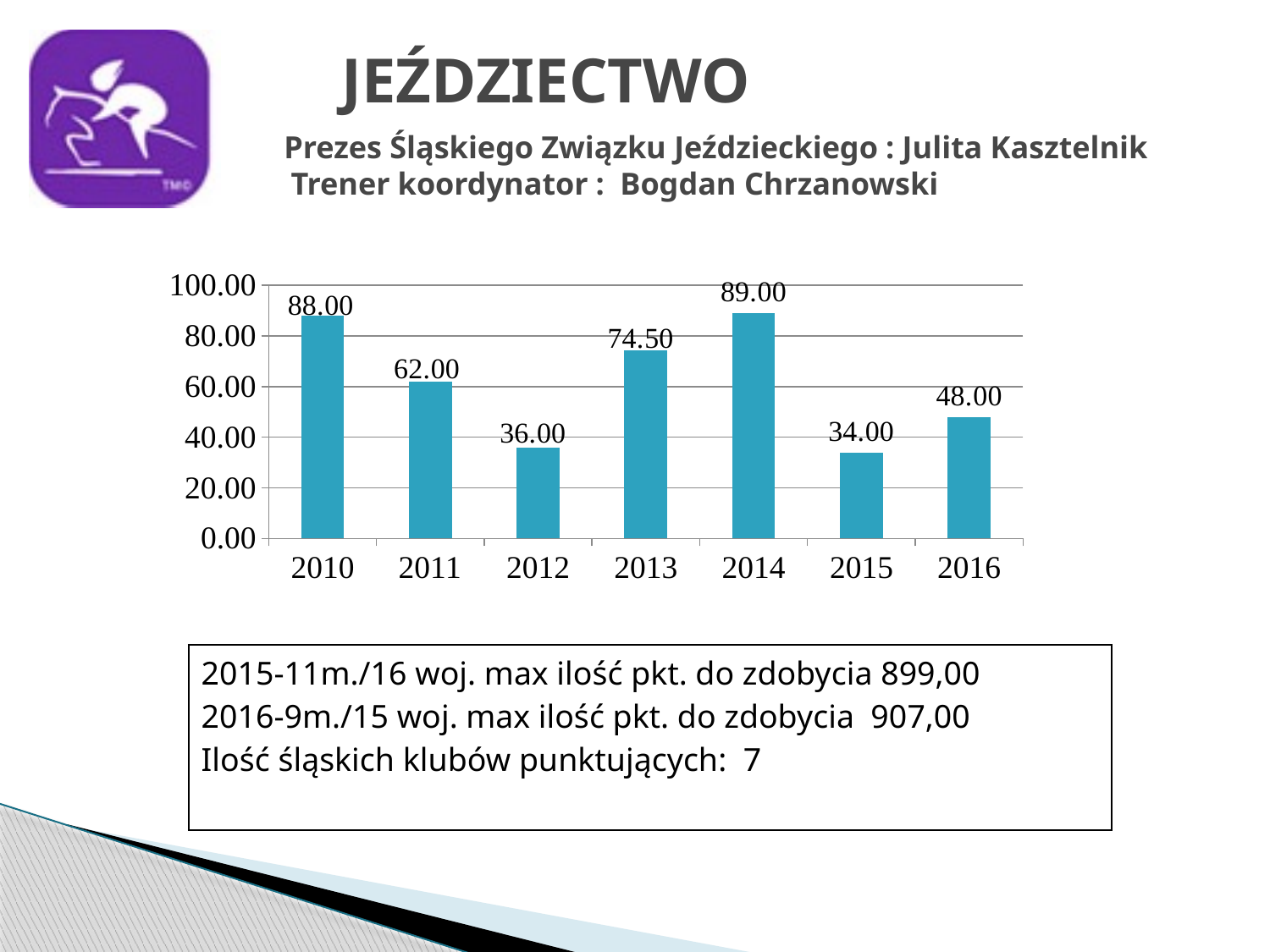
What is the value for 2013? 74.50 Which year has the highest value? 2014 How many years are shown on the x axis? 7 What kind of chart is shown on the slide? bar chart Is the value for 2013 greater or less than 60.00? greater What is the difference between the values for 2010 and 2011? 26.00 Does the value rise or fall from 2014 to 2015? fall Which year has the lowest value? 2015 What is the value for 2016? 48.00 What is the difference between the values for 2014 and 2015? 55.00 What is the value for 2010? 88.00 Which is larger, the value for 2012 or the value for 2016? 2016